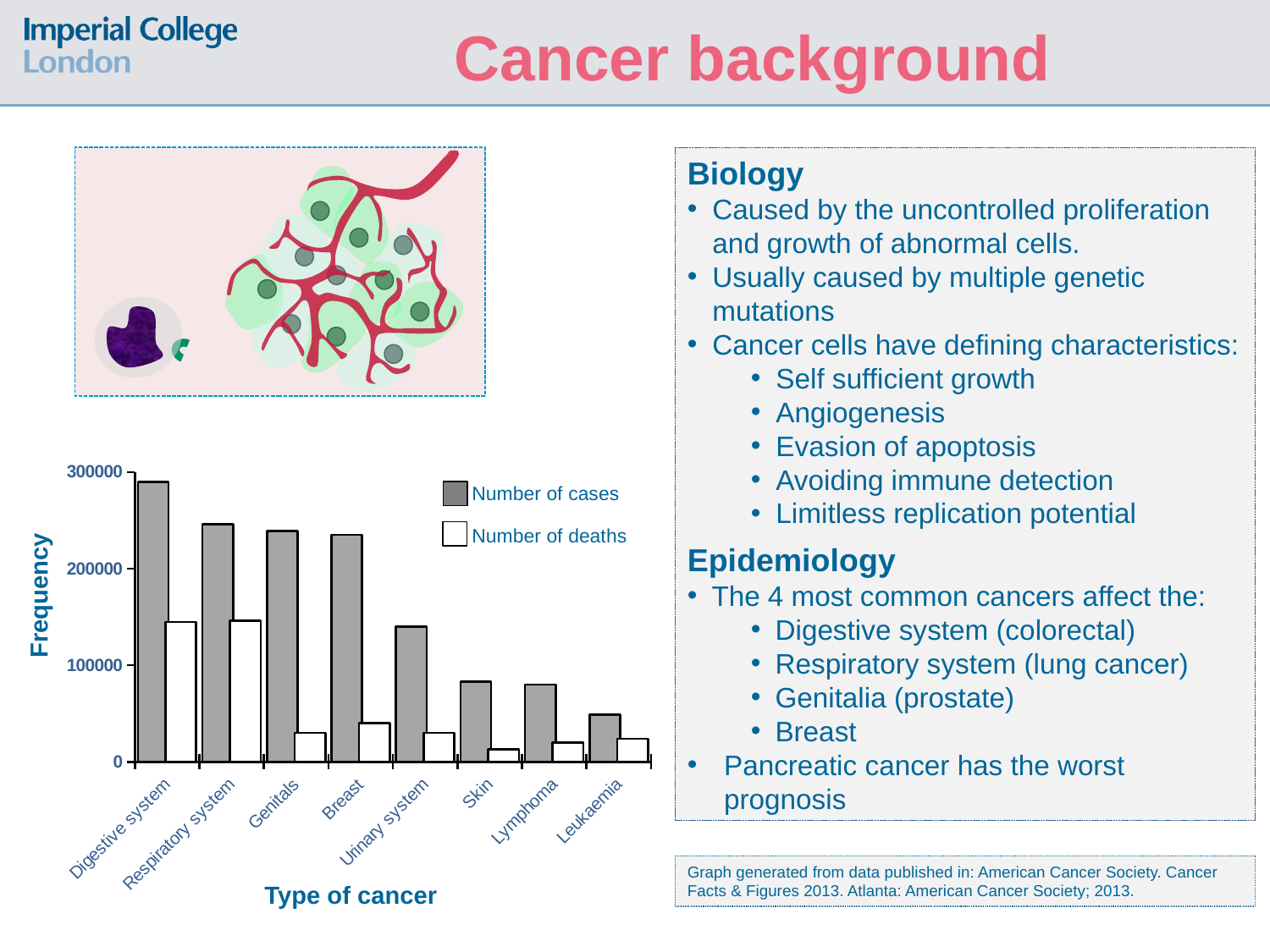
What is the label of the y axis of the chart? Frequency How many series does the chart's legend list? 2 Which type of cancer has the highest number of cases? Digestive system Is the number of cases for Skin greater or less than 100000? less Is the number of cases for Urinary system greater or less than 100000? greater Do the number of cases generally rise or fall moving from left to right along the x axis? fall Which type of cancer has the lowest number of cases? Leukaemia Is the number of cases for Digestive system greater or less than 200000? greater What kind of chart is shown on the slide? bar chart Which is larger: the number of cases for Digestive system or the number of cases for Breast? Digestive system How many types of cancer are shown on the x axis of the chart? 8